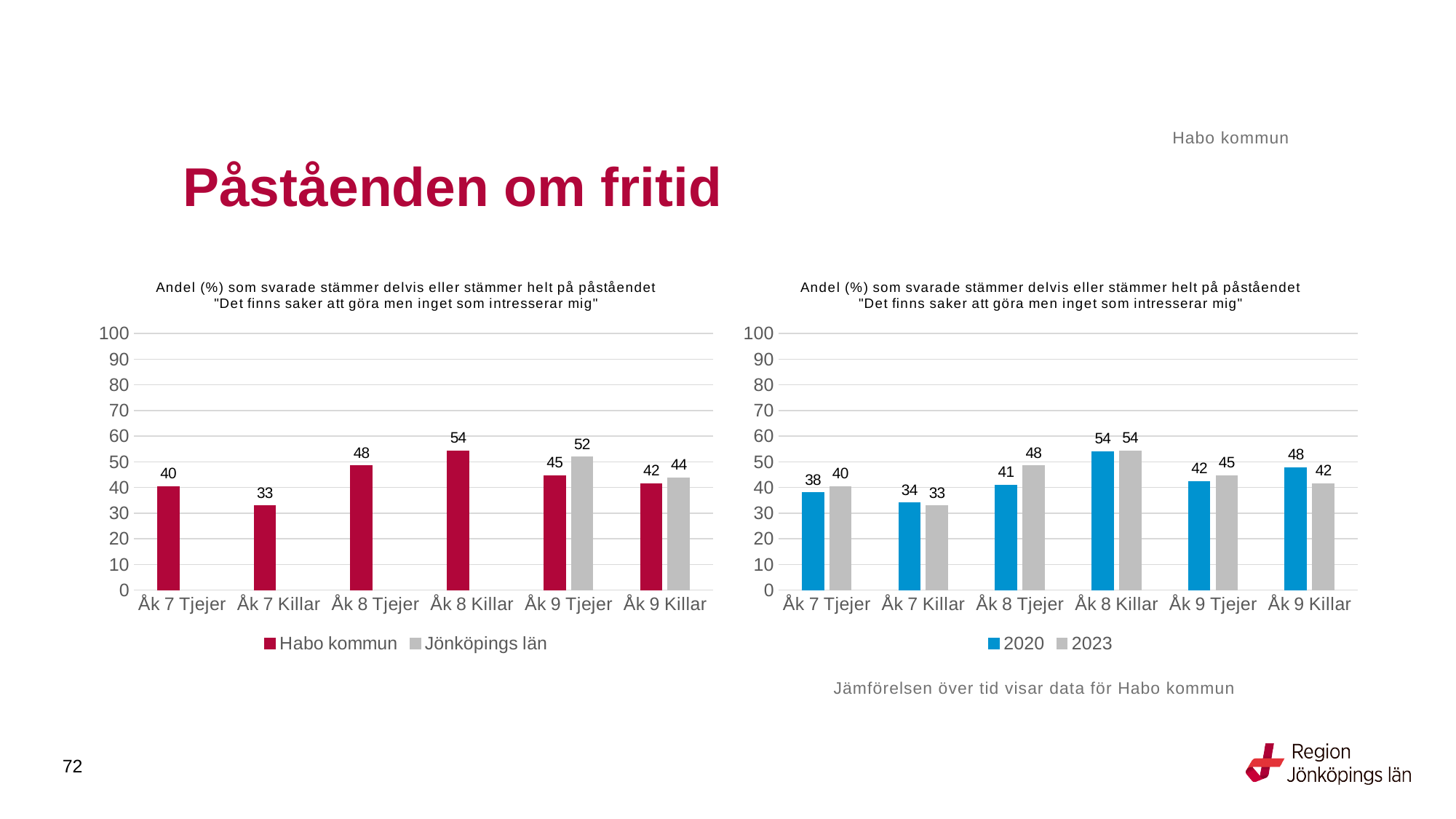
What kind of chart is the left chart? Bar chart In the right chart, what is the value for 2023 for Åk 9 Killar? 42 In the left chart, how many series does the legend list? 2 In the left chart, what is the value for Jönköpings län for Åk 9 Tjejer? 52 In the right chart, which category has the highest value for 2023? Åk 8 Killar In the right chart, what is the value for 2020 for Åk 8 Tjejer? 41 In the left chart, which category has the lowest value for Habo kommun? Åk 7 Killar In the left chart, what is the value for Habo kommun for Åk 8 Killar? 54 In the left chart, what is the difference between Jönköpings län and Habo kommun for Åk 9 Tjejer? 7 In the right chart, which is larger for Åk 9 Killar, the 2020 value or the 2023 value? 2020 In the right chart, what is the difference between the 2023 and 2020 values for Åk 8 Tjejer? 7 How many categories are shown on the x axis of the right chart? 6